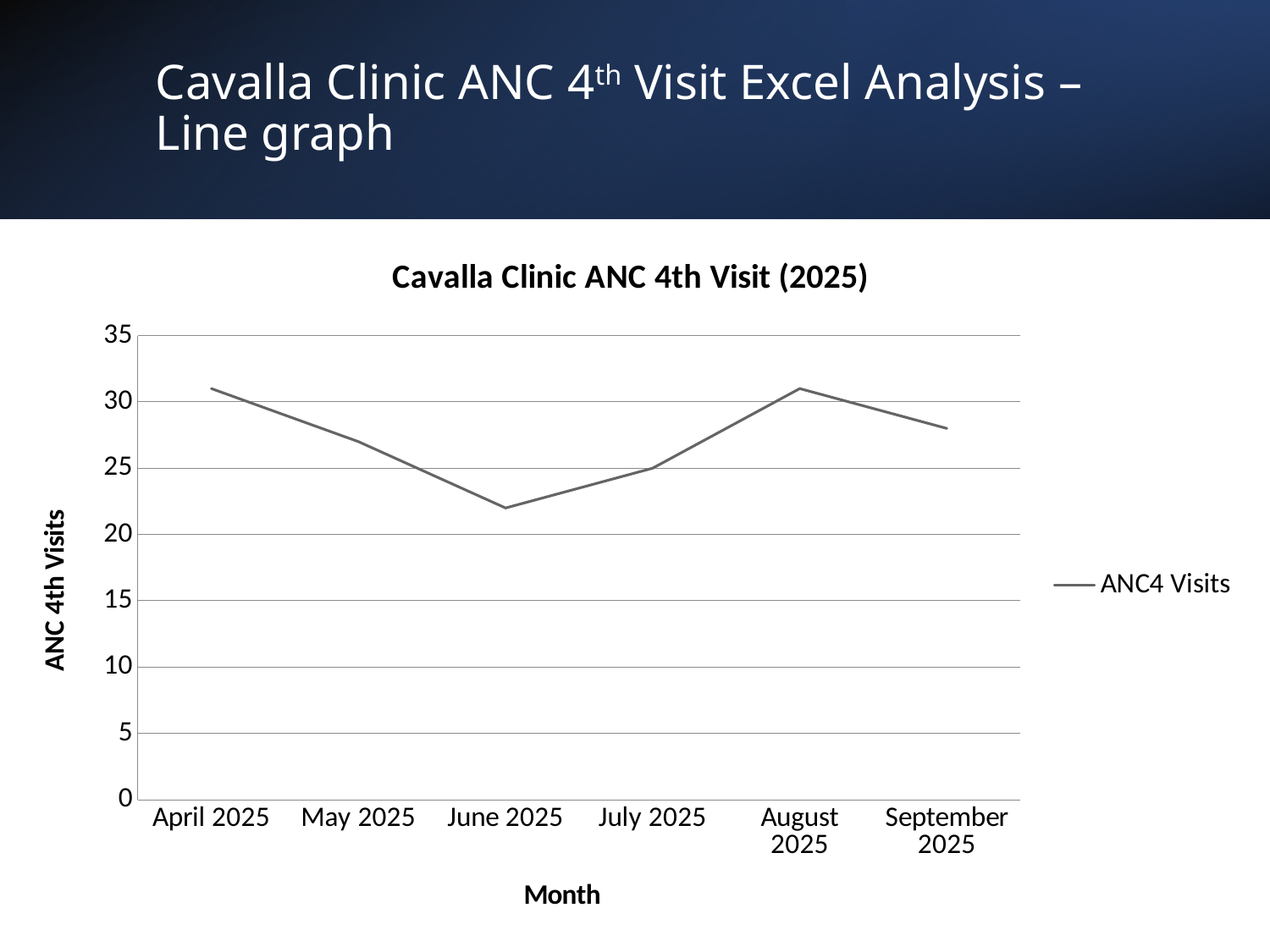
Is the value for May 2025 greater or less than 25? greater Which month has the lowest number of ANC4 visits? June 2025 Is the value for June 2025 greater or less than 25? less Do the values rise or fall from April 2025 to June 2025? fall What kind of chart is shown on the slide? line chart How many months are plotted on the x axis? 6 Do the values rise or fall from June 2025 to August 2025? rise Is the value for April 2025 greater or less than 30? greater How many series does the legend list? 1 Which is larger, the value for April 2025 or the value for June 2025? April 2025 What is the title of the chart? Cavalla Clinic ANC 4th Visit (2025)